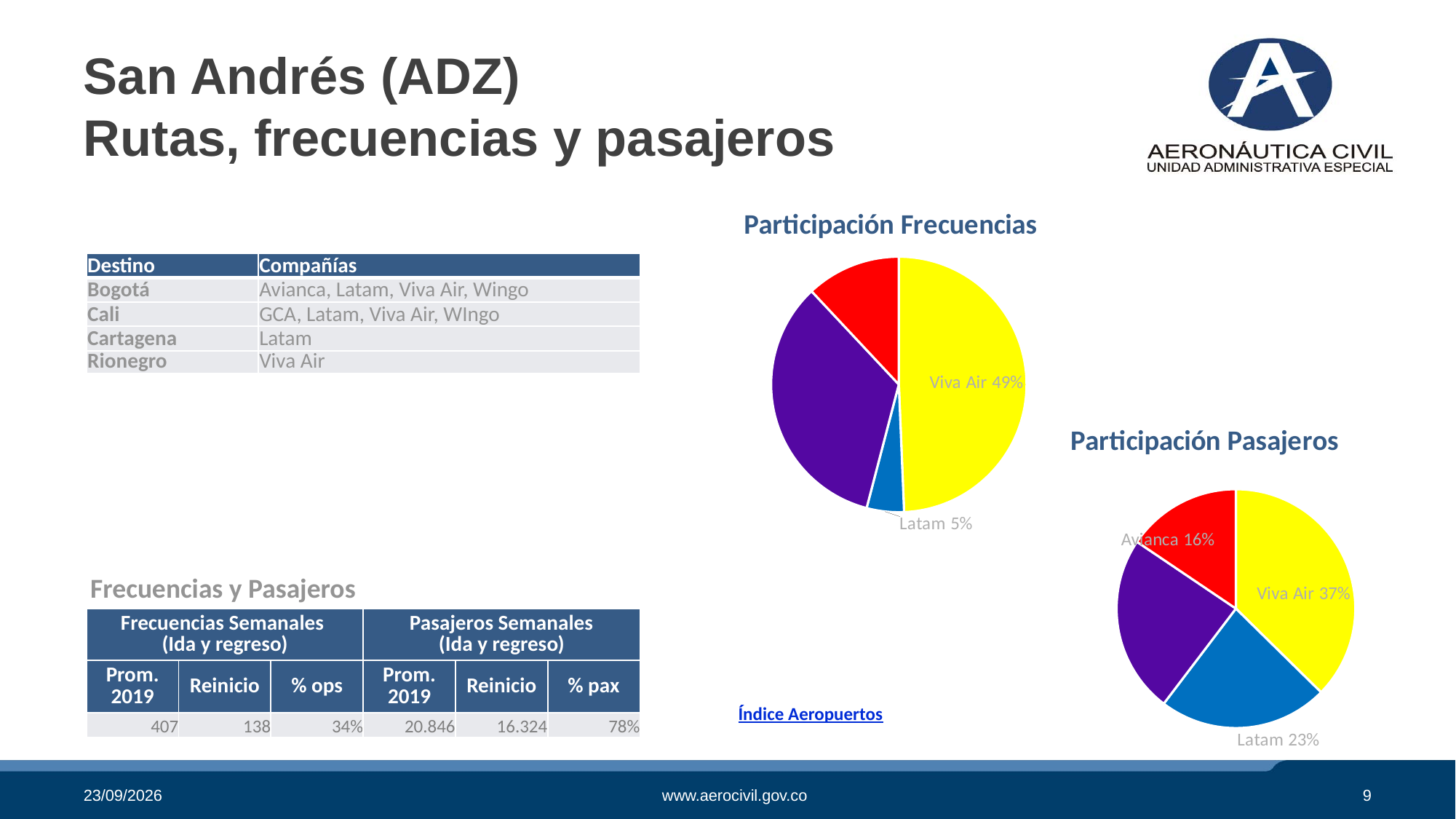
In the Participación Pasajeros chart, how many percentage points larger is Viva Air's share than Latam's? 14 percentage points In the Participación Frecuencias chart, what share does Viva Air have? 49% In the Participación Frecuencias chart, what share does Latam have? 5% In the Participación Frecuencias chart, which airline has the largest slice? Viva Air In the Participación Pasajeros chart, what share does Latam have? 23% In the Participación Pasajeros chart, what share does Avianca have? 16% In the Participación Frecuencias chart, how many percentage points larger is Viva Air's share than Latam's? 44 percentage points In the Participación Pasajeros chart, which is larger, Viva Air's share or Latam's share? Viva Air In the Participación Frecuencias chart, which airline has the smallest slice? Latam In the Participación Pasajeros chart, what share does Viva Air have? 37% How many slices does the Participación Pasajeros pie chart have? 4 What kind of chart is the Participación Frecuencias chart? Pie chart